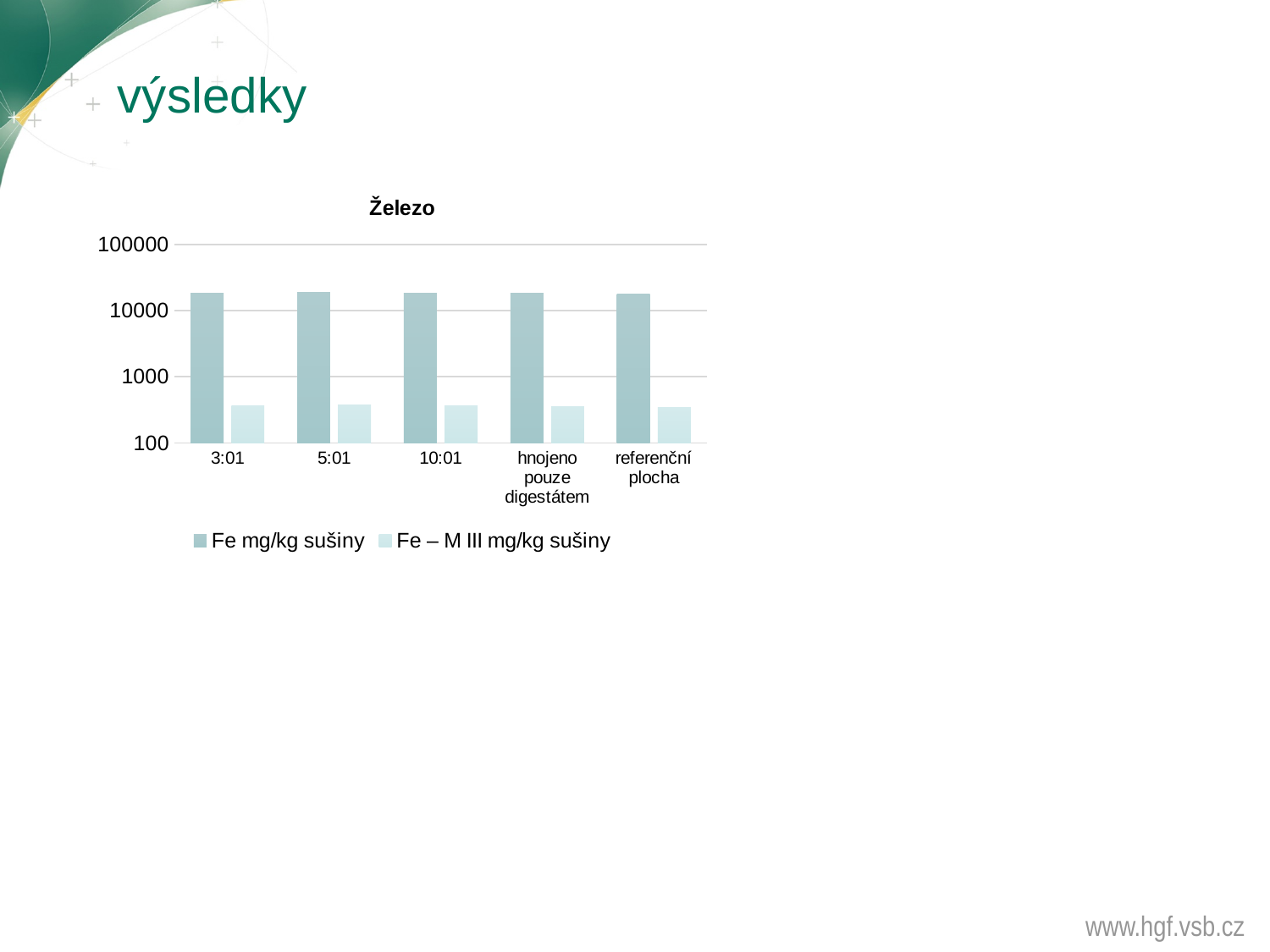
How many categories are shown on the x axis? 5 Is the value of Fe mg/kg sušiny for hnojeno pouze digestátem greater or less than 100000? less Is the value of Fe mg/kg sušiny for 3:01 greater or less than 10000? greater Which is larger: Fe mg/kg sušiny for referenční plocha or Fe – M III mg/kg sušiny for 3:01? Fe mg/kg sušiny for referenční plocha What is the title of the chart? Železo How many series does the legend list? 2 For 10:01, which series has the larger value, Fe mg/kg sušiny or Fe – M III mg/kg sušiny? Fe mg/kg sušiny Is the value of Fe mg/kg sušiny for 5:01 greater or less than 1000? greater What kind of chart is shown on the slide? bar chart What is the name of the second series in the legend? Fe – M III mg/kg sušiny